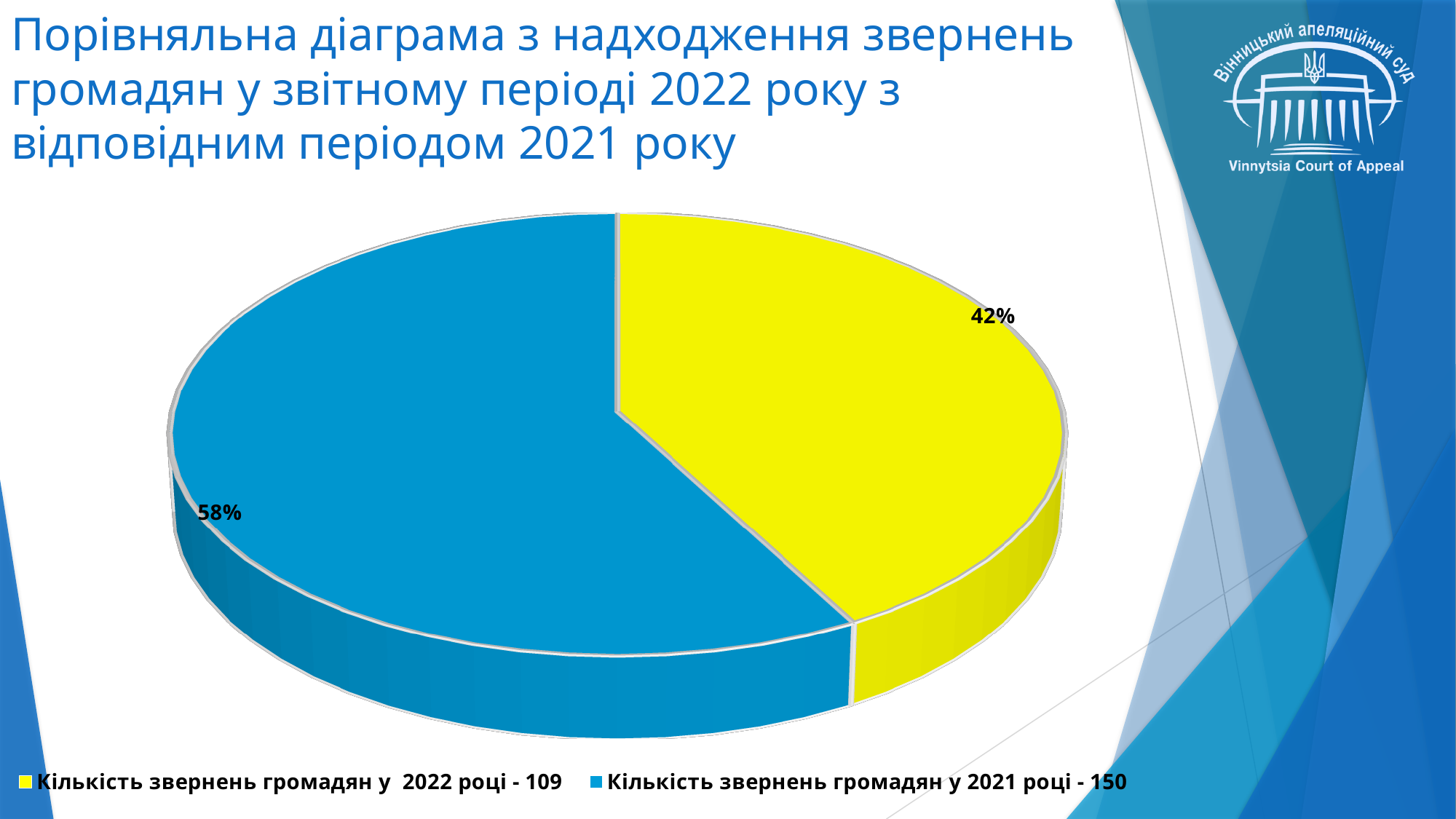
What percentage share is shown for the number of citizens' appeals in 2021? 58% How many entries does the legend list? 2 What percentage share is shown for the number of citizens' appeals in 2022? 42% According to the legend, how many citizens' appeals were received in 2021? 150 Which year has the larger slice of the pie, 2021 or 2022? 2021 What kind of chart is shown on the slide? Pie chart Which year has the smallest share of the pie? 2022 What colour is the slice representing the 2022 appeals? Yellow What is the difference between the number of appeals in 2021 and in 2022? 41 How many slices does the pie chart have? 2 What colour is the slice representing the 2021 appeals? Blue According to the legend, how many citizens' appeals were received in 2022? 109